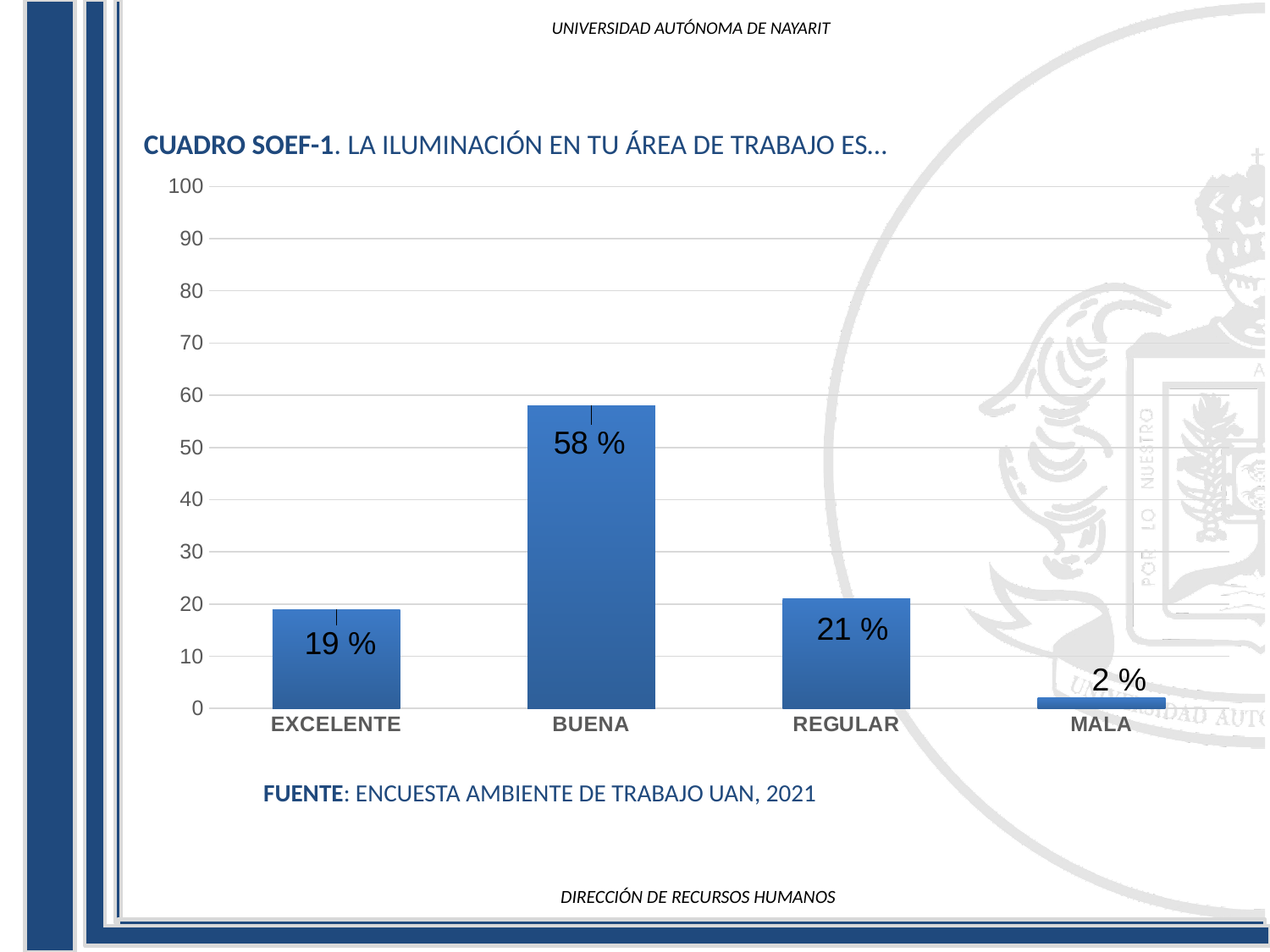
What is the value for EXCELENTE? 19 % Which category has the lowest value? MALA Which is larger, the value for EXCELENTE or the value for MALA? EXCELENTE What is the difference between the values for REGULAR and EXCELENTE? 2 % What is the value for MALA? 2 % What kind of chart is shown on the slide? bar chart What is the difference between the values for BUENA and REGULAR? 37 % What is the value for BUENA? 58 % What is the value for REGULAR? 21 % Which category has the highest value? BUENA How many categories are shown on the x axis? 4 Is the value for BUENA greater or less than 50? greater